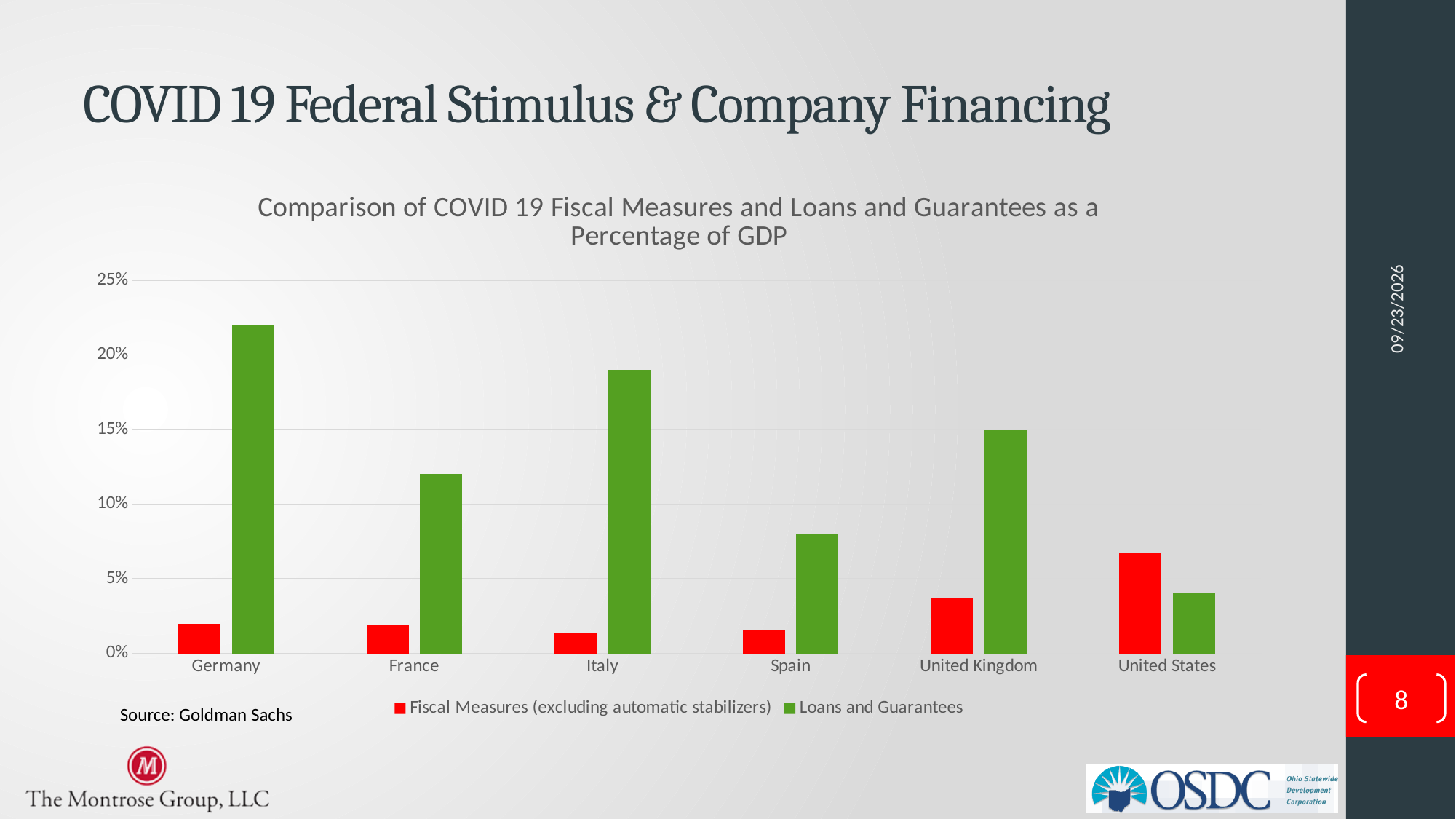
What colour are the Loans and Guarantees bars in the chart? green Which is larger for Italy: Fiscal Measures (excluding automatic stabilizers) or Loans and Guarantees? Loans and Guarantees Which country has the highest Loans and Guarantees value? Germany Which country has the lowest Loans and Guarantees value? United States Which country has the highest Fiscal Measures (excluding automatic stabilizers) value? United States Is the Loans and Guarantees value for Spain greater or less than 10%? less How many countries are shown on the x axis of the chart? 6 What type of chart is shown on the slide? bar chart How many series does the chart's legend list? 2 What is the Loans and Guarantees value for the United Kingdom? 15% Is the Fiscal Measures (excluding automatic stabilizers) value for the United States greater or less than 5%? greater Is the Loans and Guarantees value for Germany greater or less than 20%? greater